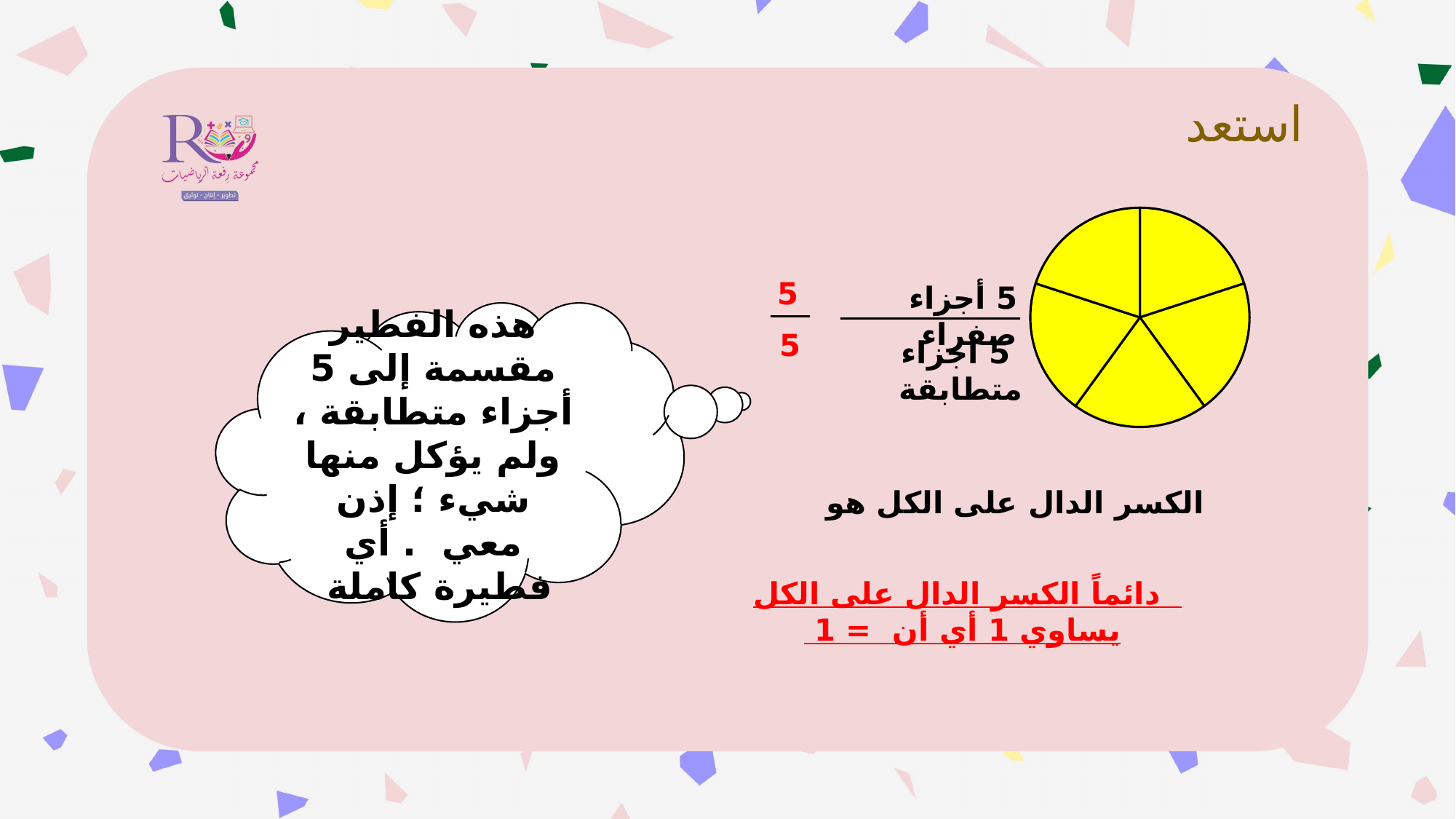
What colour are the slices of the pie chart? yellow Are the slices of the pie chart equal in size? yes How many slices is the pie chart divided into? 5 What kind of chart is shown on the slide? pie chart According to the slide, what fraction represents the whole pie (all 5 yellow parts out of 5 equal parts)? 5/5 How many of the pie chart's 5 slices are yellow? 5